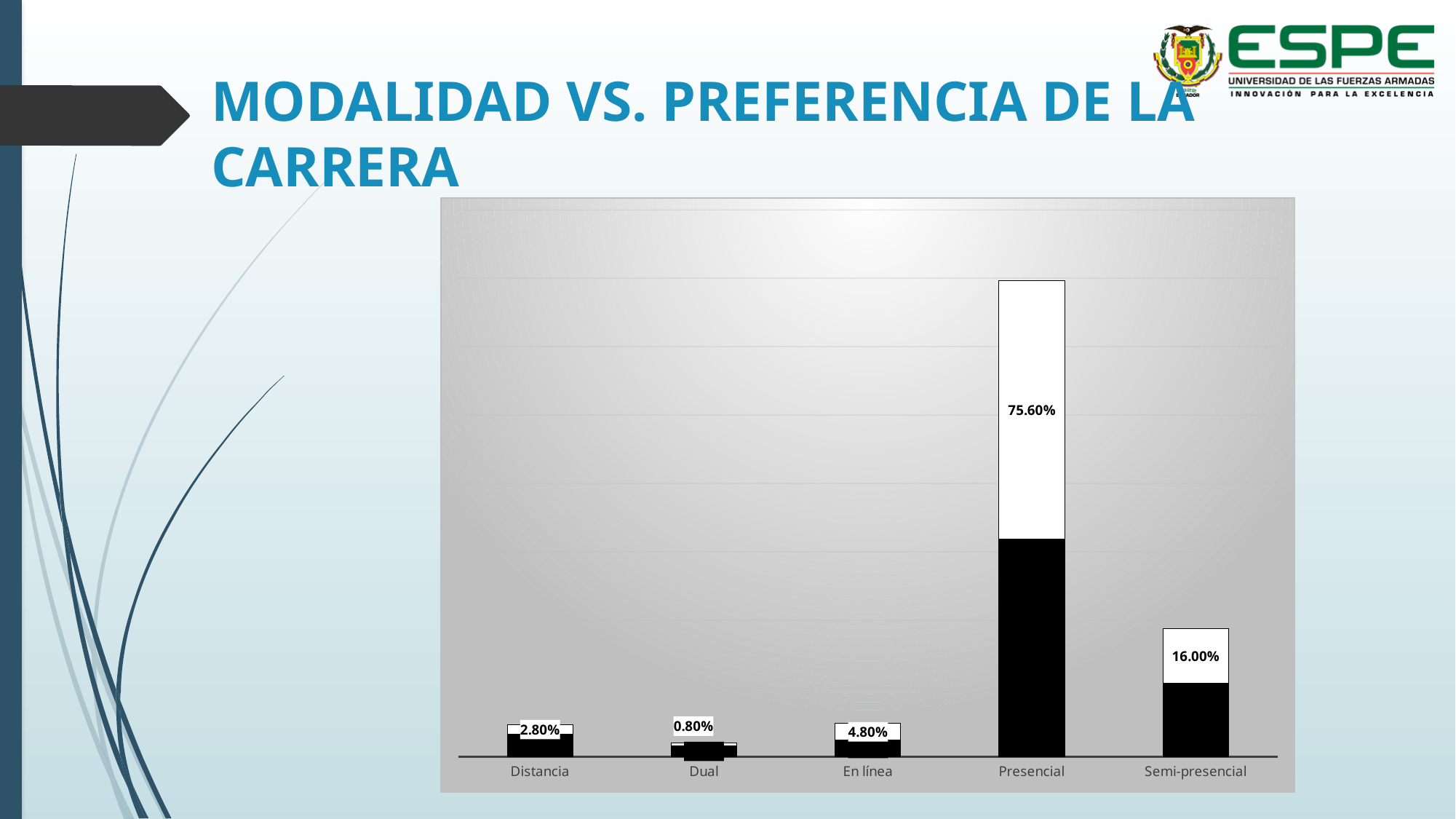
How many categories are shown on the x axis? 5 Which is larger, the value for Distancia or the value for En línea? En línea What is the difference between the values for En línea and Distancia? 2.00% What is the value shown for Presencial? 75.60% Which category has the highest value? Presencial Which category has the lowest value? Dual What is the difference between the values for Presencial and Semi-presencial? 59.60% What kind of chart is shown on the slide? Bar chart What is the value shown for Distancia? 2.80% What is the value shown for Semi-presencial? 16.00% What is the value shown for Dual? 0.80% What is the value shown for En línea? 4.80%